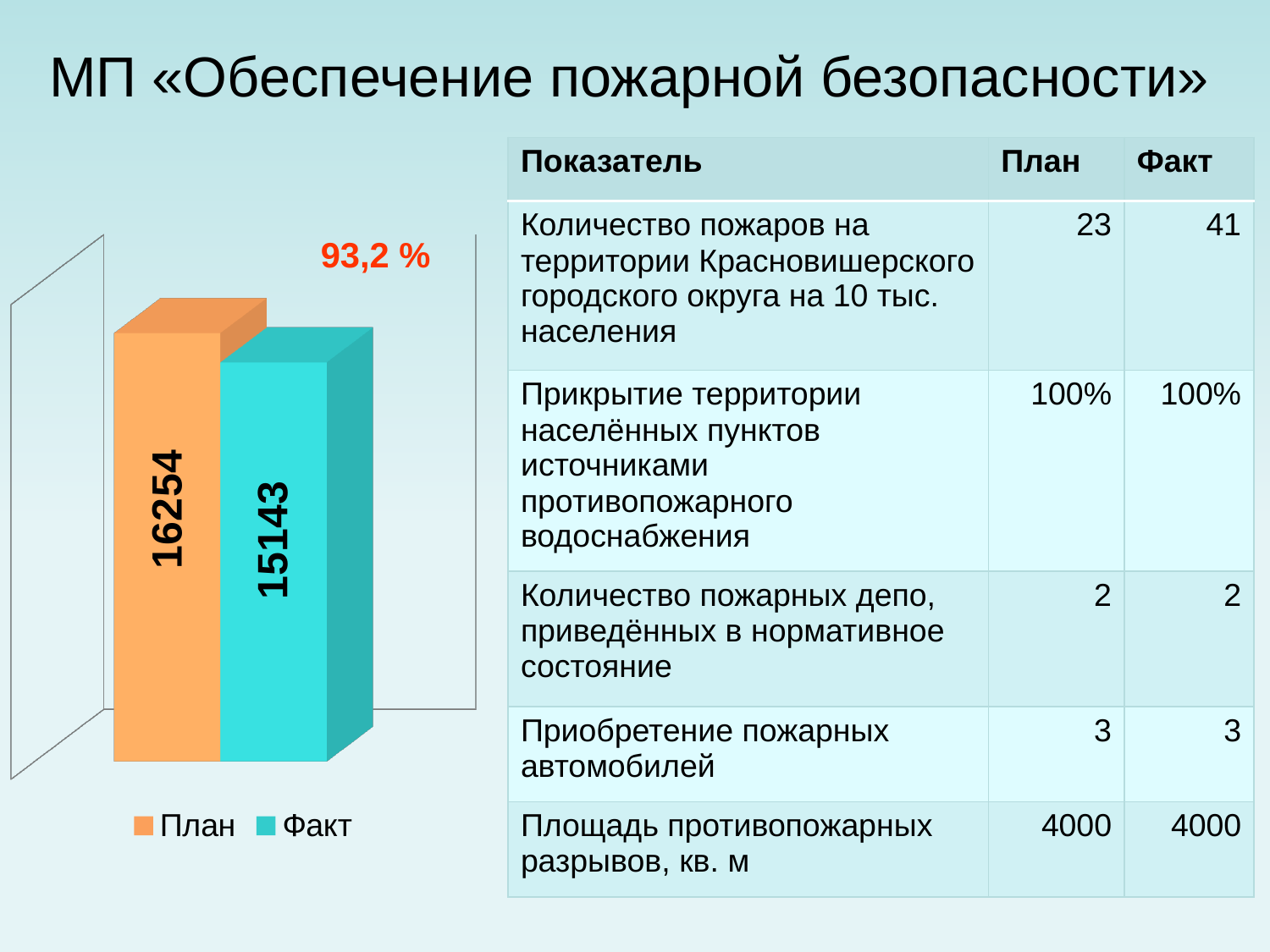
Which series has the highest value in the chart? План What kind of chart is shown on the slide? bar chart What colour is the Факт bar in the chart? teal What is the difference between the План and Факт values in the chart? 1111 Which series has the lowest value in the chart? Факт What percentage is printed above the bars in the chart? 93,2 % How many bars are plotted in the chart? 2 What is the value of the План bar in the chart? 16254 Which bar in the chart is taller, План or Факт? План How many series does the chart legend list? 2 What is the value of the Факт bar in the chart? 15143